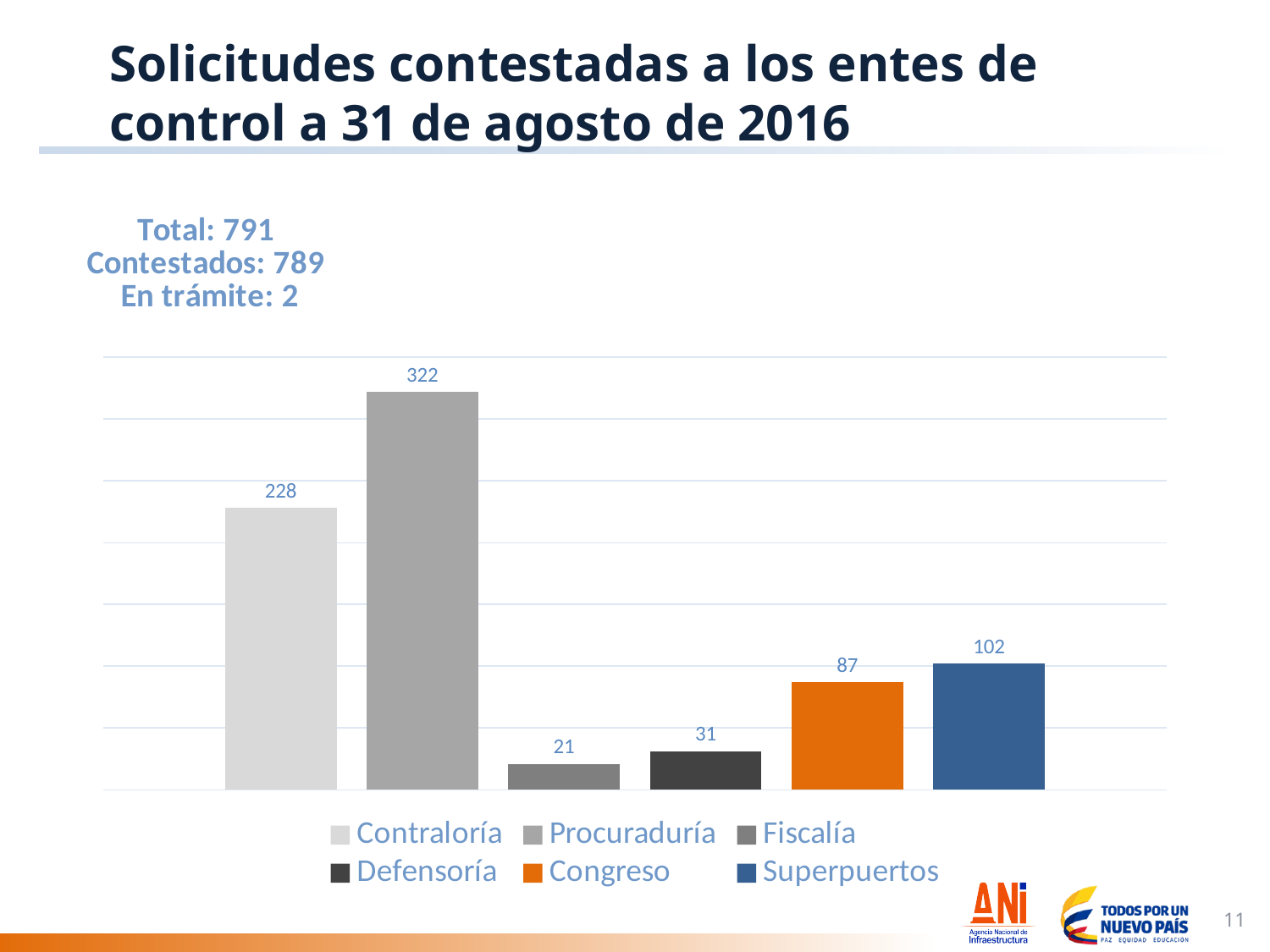
Which is larger, the value for Defensoría or the value for Fiscalía? Defensoría Which entity has the highest value? Procuraduría Which entity has the lowest value? Fiscalía What is the difference between the values for Procuraduría and Contraloría? 94 How many entries does the legend list? 6 What is the value for Procuraduría? 322 What is the value for Congreso? 87 What kind of chart is shown on the slide? Bar chart What is the difference between the values for Superpuertos and Congreso? 15 What is the value for Contraloría? 228 How many bars are plotted in the chart? 6 What is the value for Superpuertos? 102